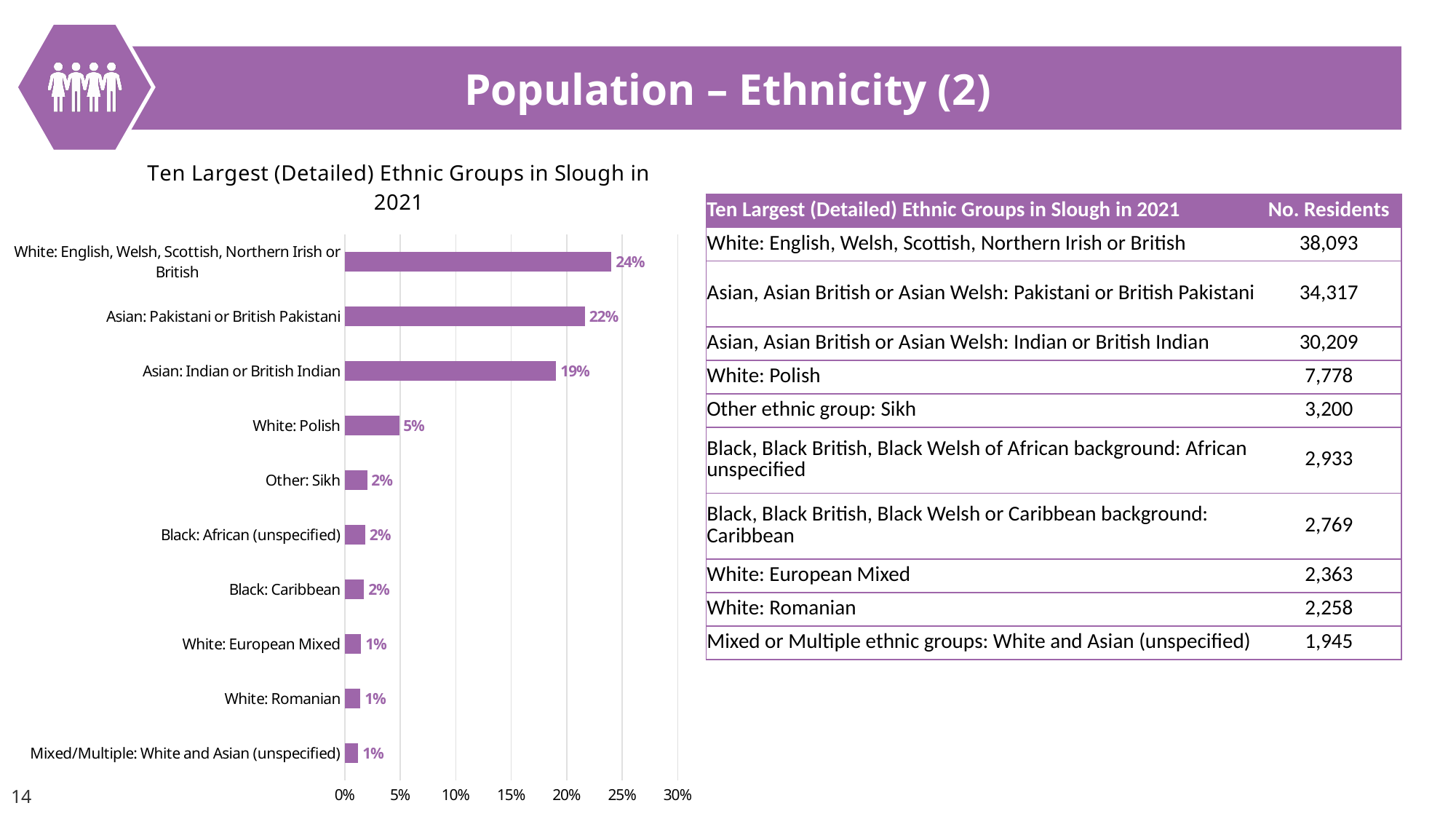
What is the value for Asian: Pakistani or British Pakistani in the chart? 22% What is the highest value shown on the chart's percentage axis? 30% What is the value for White: Polish in the chart? 5% What is the difference between the values for Asian: Pakistani or British Pakistani and White: Polish? 17% Is the value for White: English, Welsh, Scottish, Northern Irish or British greater or less than 20%? greater Which ethnic group has the highest value in the chart? White: English, Welsh, Scottish, Northern Irish or British What is the title of the chart? Ten Largest (Detailed) Ethnic Groups in Slough in 2021 What kind of chart is shown on the slide? Bar chart How many ethnic groups are shown in the chart? 10 What is the difference between the values for White: English, Welsh, Scottish, Northern Irish or British and Asian: Pakistani or British Pakistani? 2% What is the value for Asian: Indian or British Indian in the chart? 19% Which is larger, the value for Asian: Indian or British Indian or the value for White: Polish? Asian: Indian or British Indian